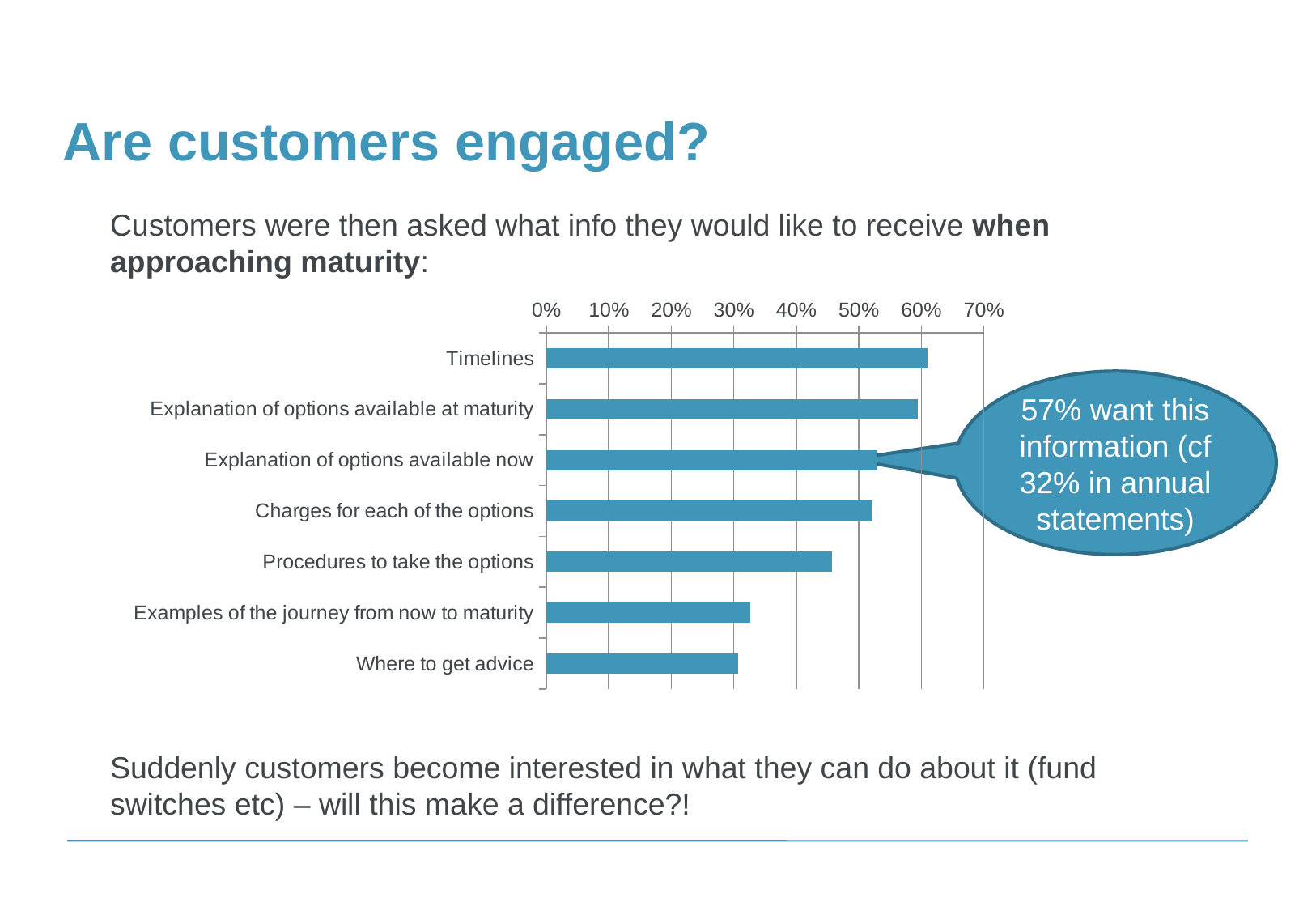
Is the value for Where to get advice greater or less than 40%? less What is the highest value shown on the chart's percentage axis? 70% Is the value for Explanation of options available at maturity greater or less than 50%? greater What kind of chart is shown on the slide? bar chart Is the value for Examples of the journey from now to maturity greater or less than 40%? less According to the callout, what percentage of customers want an explanation of options available now? 57% How many categories of information are shown in the chart? 7 Which is larger, the value for Procedures to take the options or the value for Examples of the journey from now to maturity? Procedures to take the options According to the callout, what percentage wanted this information in annual statements? 32% Which is larger, the value for Timelines or the value for Where to get advice? Timelines